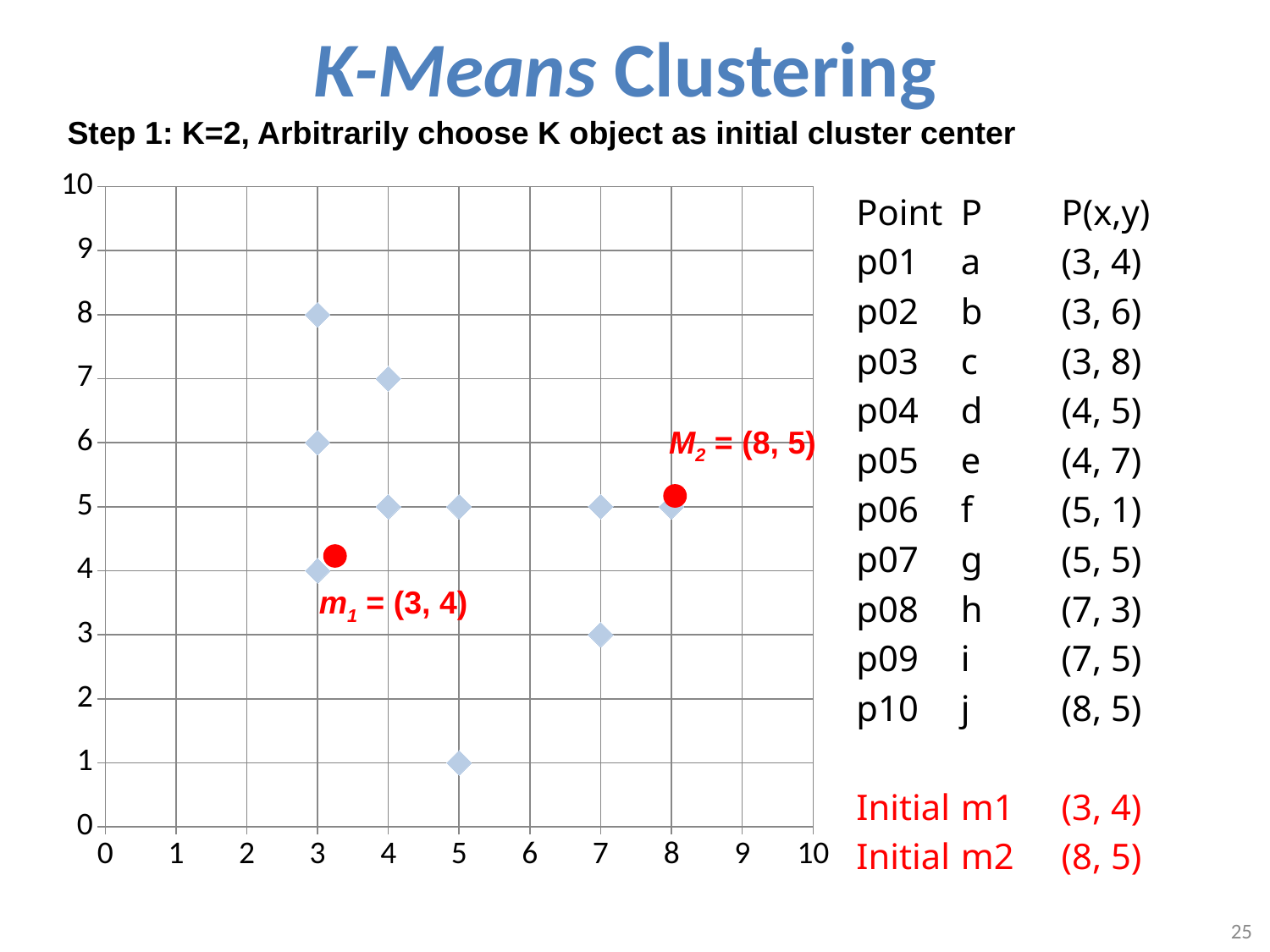
What is the difference in y value between point c (3, 8) and point a (3, 4)? 4 What are the coordinates of point c (p03)? (3, 8) Which point has the larger x value, h (7, 3) or d (4, 5)? h How many points have an x value of 3? 3 Which point has the highest y value? c (3, 8) What kind of chart is shown on the slide? scatter chart What are the coordinates of the initial cluster center m1? (3, 4) How many blue data points are plotted on the chart? 10 Is the x value of point j greater or less than 5? greater What are the coordinates of the initial cluster center M2? (8, 5) Which point has the lowest y value? f (5, 1) What is the maximum value shown on the y axis? 10